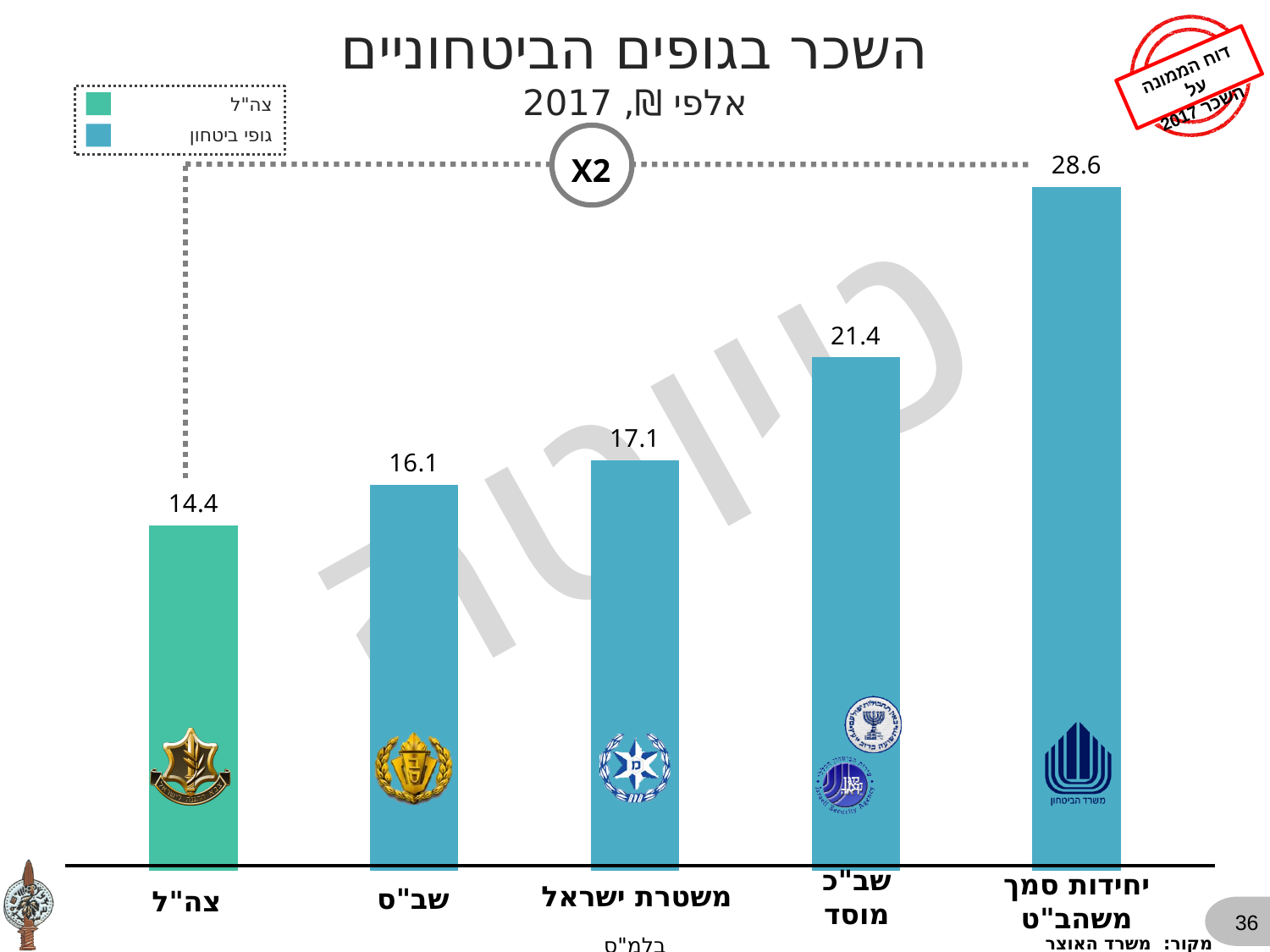
Which is larger, the value for שב"ס or the value for משטרת ישראל? משטרת ישראל What is the difference between the values for יחידות סמך משהב"ט and צה"ל? 14.2 What is the difference between the values for שב"כ מוסד and שב"ס? 5.3 Which category has the lowest value? צה"ל Which category has the highest value? יחידות סמך משהב"ט How many entries does the legend list? 2 What is the value for יחידות סמך משהב"ט? 28.6 What kind of chart is shown on the slide? bar chart What is the value for צה"ל in the chart? 14.4 How many categories are shown in the chart? 5 What is the value for שב"כ מוסד? 21.4 What is the value for משטרת ישראל? 17.1